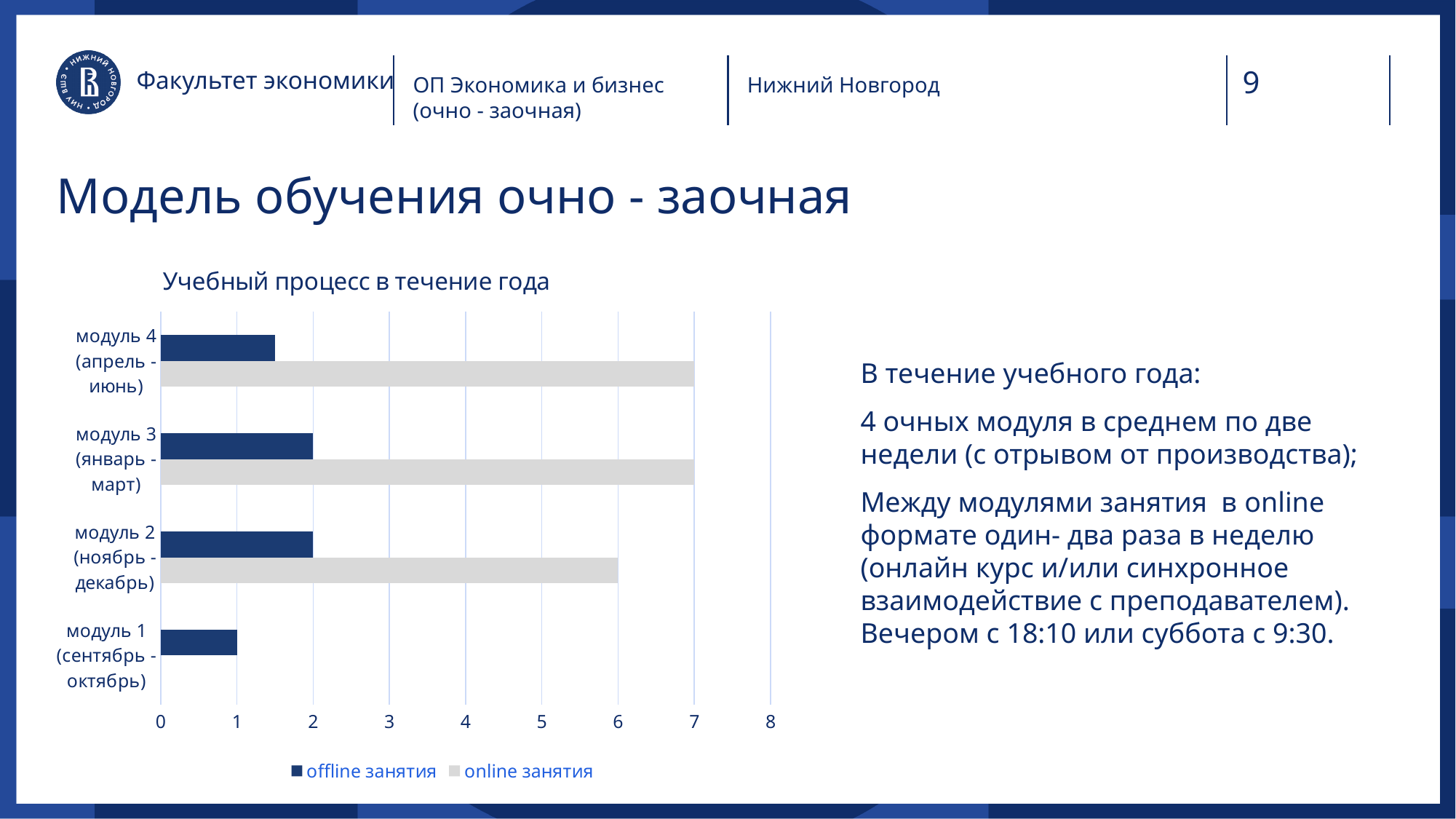
What is the value of online занятия for модуль 3 (январь - март)? 7 Which is larger: online занятия for модуль 2 or online занятия for модуль 3? модуль 3 Which series is shown in dark blue on the chart? offline занятия What is the title of the chart? Учебный процесс в течение года What is the value of offline занятия for модуль 1 (сентябрь - октябрь)? 1 What is the difference between online занятия and offline занятия for модуль 3 (январь - март)? 5 Is the value of offline занятия for модуль 4 (апрель - июнь) greater or less than 2? less Which module has the lowest value for offline занятия? модуль 1 (сентябрь - октябрь) How many series does the legend of the chart list? 2 What is the value of online занятия for модуль 2 (ноябрь - декабрь)? 6 What kind of chart is shown on the slide? bar chart How many modules (categories) are shown on the chart? 4